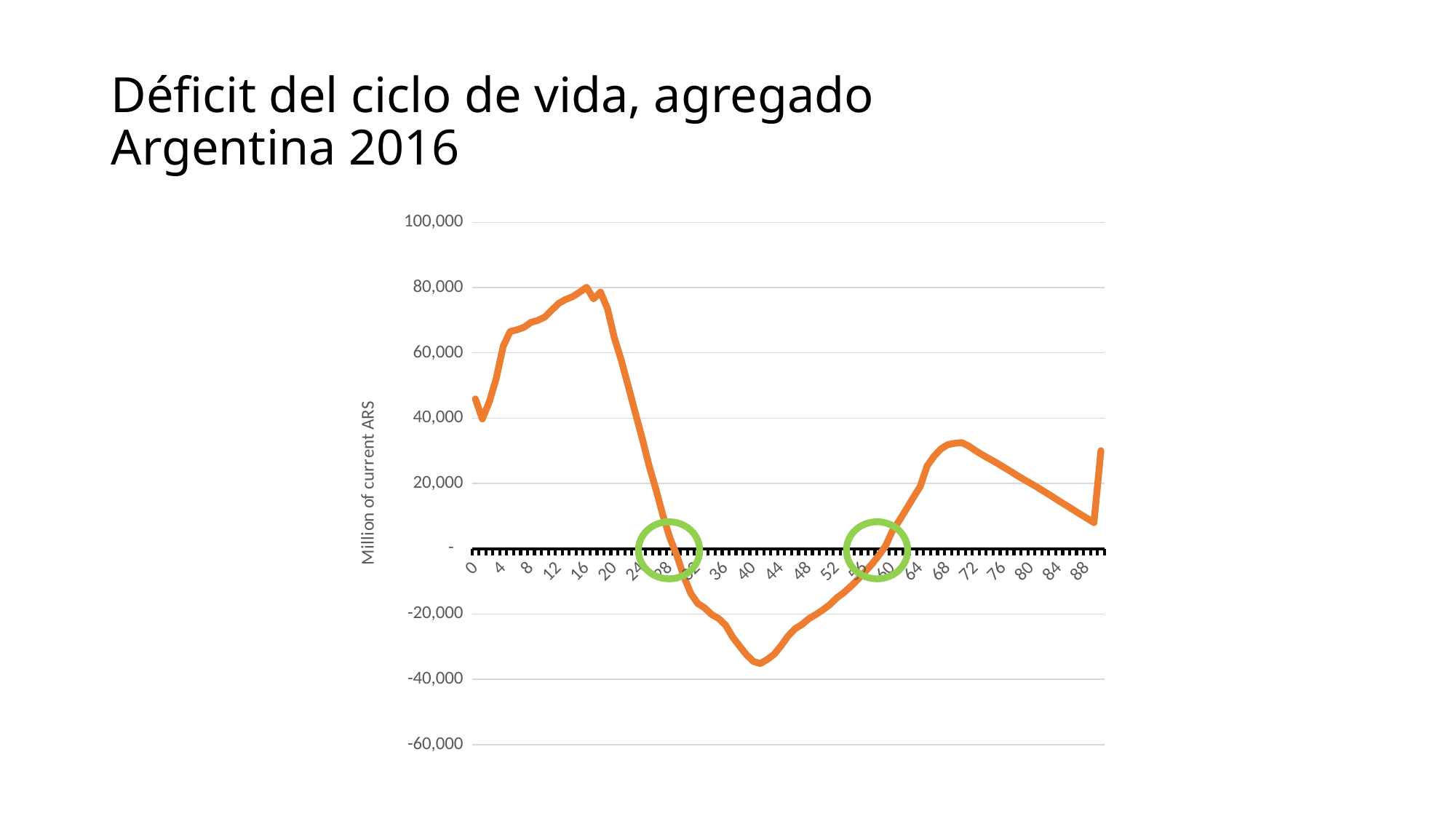
Is the value at age 84 greater or less than 0? greater What kind of chart is shown on the slide? line chart Is the value at age 16 larger or smaller than the value at age 40? larger Is the value at age 8 greater or less than 60,000? greater What is the title of the slide's chart? Déficit del ciclo de vida, agregado Argentina 2016 Is the value at age 16 greater or less than 60,000? greater Does the line rise or fall between age 40 and age 68? rise Does the line rise or fall between age 16 and age 40? fall What is the label on the vertical axis of the chart? Million of current ARS